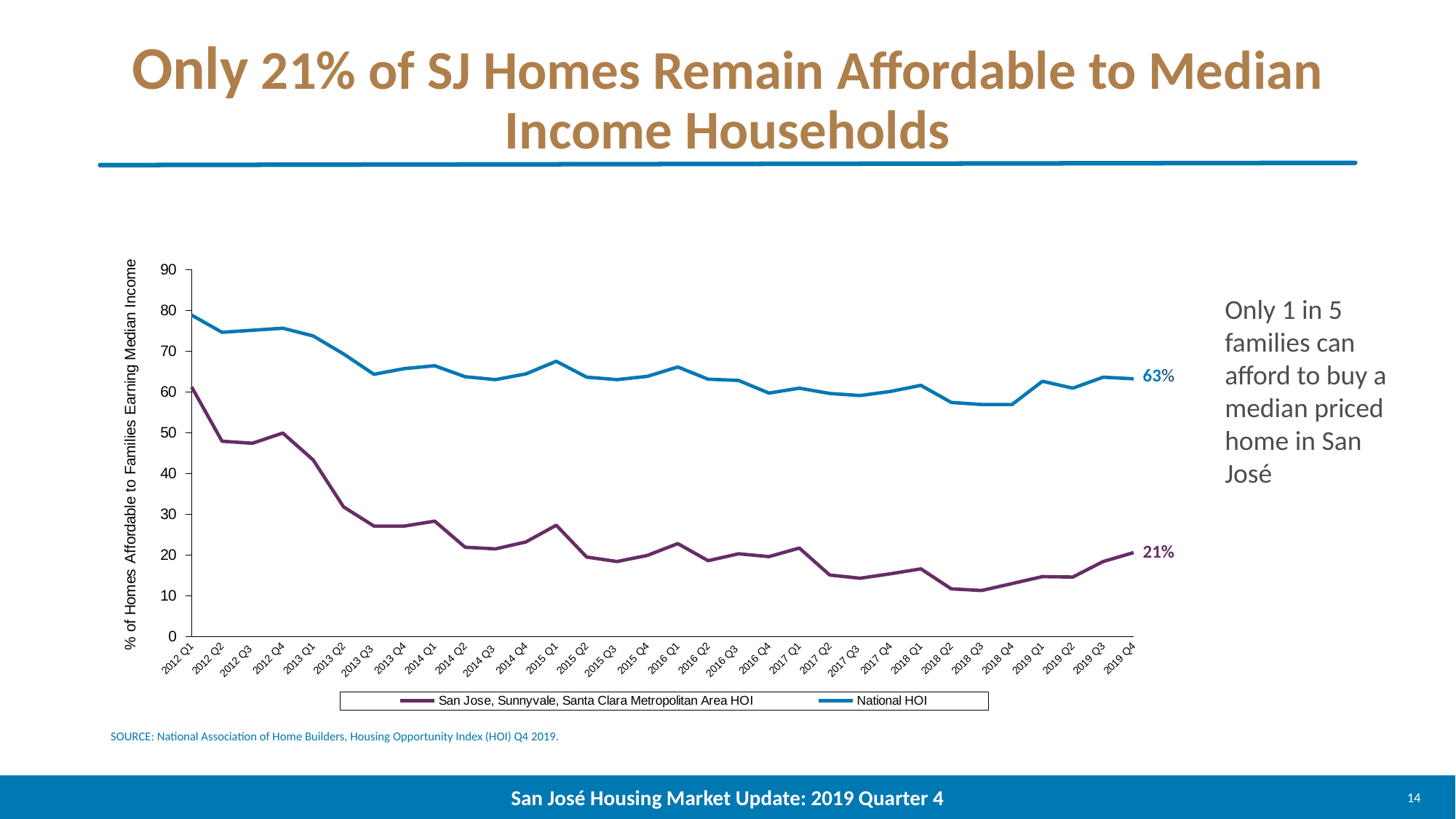
Is the value for the San Jose, Sunnyvale, Santa Clara Metropolitan Area HOI at 2018 Q3 greater or less than 20? less How many series does the chart's legend list? 2 What is the value of the San Jose, Sunnyvale, Santa Clara Metropolitan Area HOI series at 2019 Q4? 21% Is the value for the San Jose, Sunnyvale, Santa Clara Metropolitan Area HOI at 2012 Q1 greater or less than 50? greater At 2019 Q4, which series has the larger value: National HOI or San Jose, Sunnyvale, Santa Clara Metropolitan Area HOI? National HOI Is the value for the National HOI at 2012 Q1 greater or less than 70? greater Does the San Jose, Sunnyvale, Santa Clara Metropolitan Area HOI series rise or fall overall from 2012 Q1 to 2019 Q4? fall How many quarters are shown on the x axis of the chart? 32 What is the difference between the National HOI and the San Jose, Sunnyvale, Santa Clara Metropolitan Area HOI at 2019 Q4? 42% At which quarter does the San Jose, Sunnyvale, Santa Clara Metropolitan Area HOI series reach its highest value? 2012 Q1 What is the value of the National HOI series at 2019 Q4? 63% What kind of chart is shown on the slide? line chart